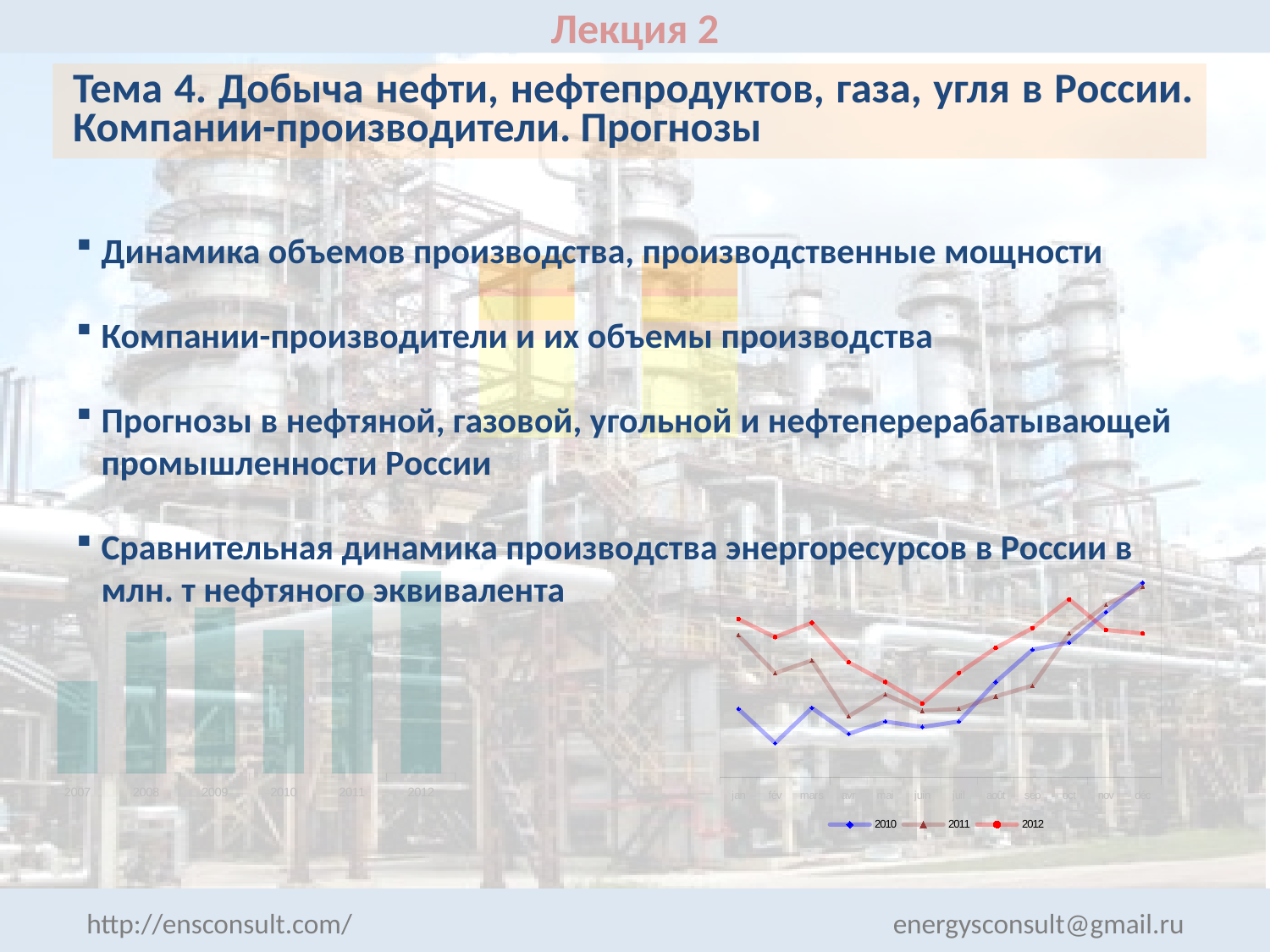
What kind of chart is the chart on the left of the slide? bar chart In the line chart on the right, in which month is the 2010 series at its lowest? fév How many bars are in the bar chart on the left of the slide? 6 How many months are shown on the x axis of the line chart on the right? 12 In the line chart on the right, does the 2010 series rise or fall from jun to déc? rise Which series are listed in the legend of the line chart on the right? 2010, 2011, 2012 In the line chart on the right, in which month is the 2012 series at its lowest? juin In the line chart on the right, which series is higher in jan: 2010 or 2012? 2012 In the line chart on the right, in which month is the 2010 series at its highest? déc What kind of chart is the chart on the right of the slide? line chart Which year has the shortest bar in the bar chart on the left? 2007 How many series does the legend of the line chart on the right list? 3